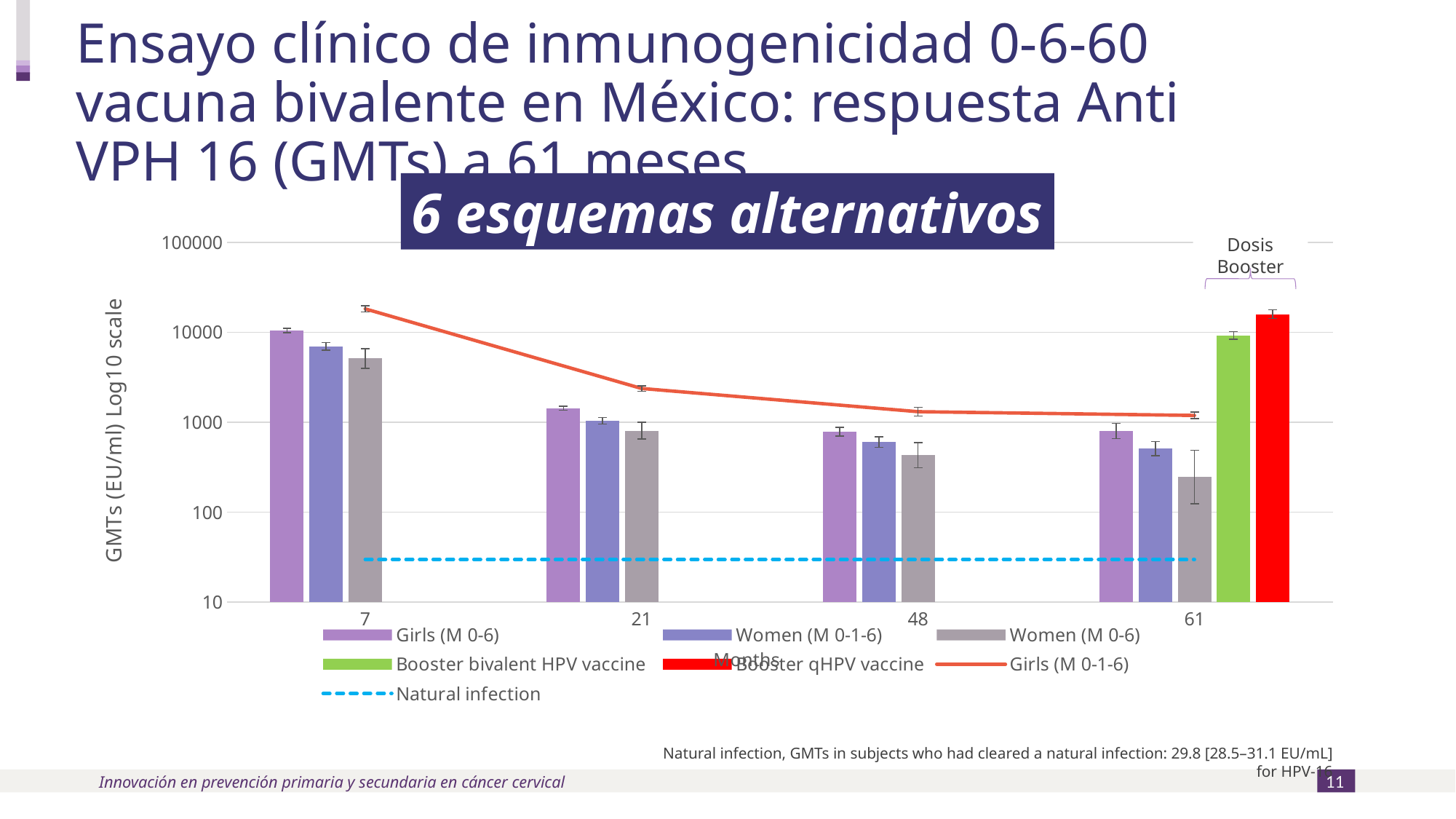
Does the Girls (M 0-1-6) line rise or fall from 7 months to 61 months? Fall Which is larger at 7 months, Girls (M 0-6) or Women (M 0-6)? Girls (M 0-6) Is the value for Women (M 0-1-6) at 7 months greater or less than 10000? less Which booster bar is higher, Booster bivalent HPV vaccine or Booster qHPV vaccine? Booster qHPV vaccine What is the label of the y axis of the chart? GMTs (EU/ml) Log10 scale How many series does the chart legend list? 7 How many month categories are shown on the x axis of the chart? 4 Is the value for Women (M 0-6) at 48 months greater or less than 1000? less Is the value for Girls (M 0-1-6) at 7 months greater or less than 10000? greater What kind of chart is shown on the slide? Combined bar and line chart